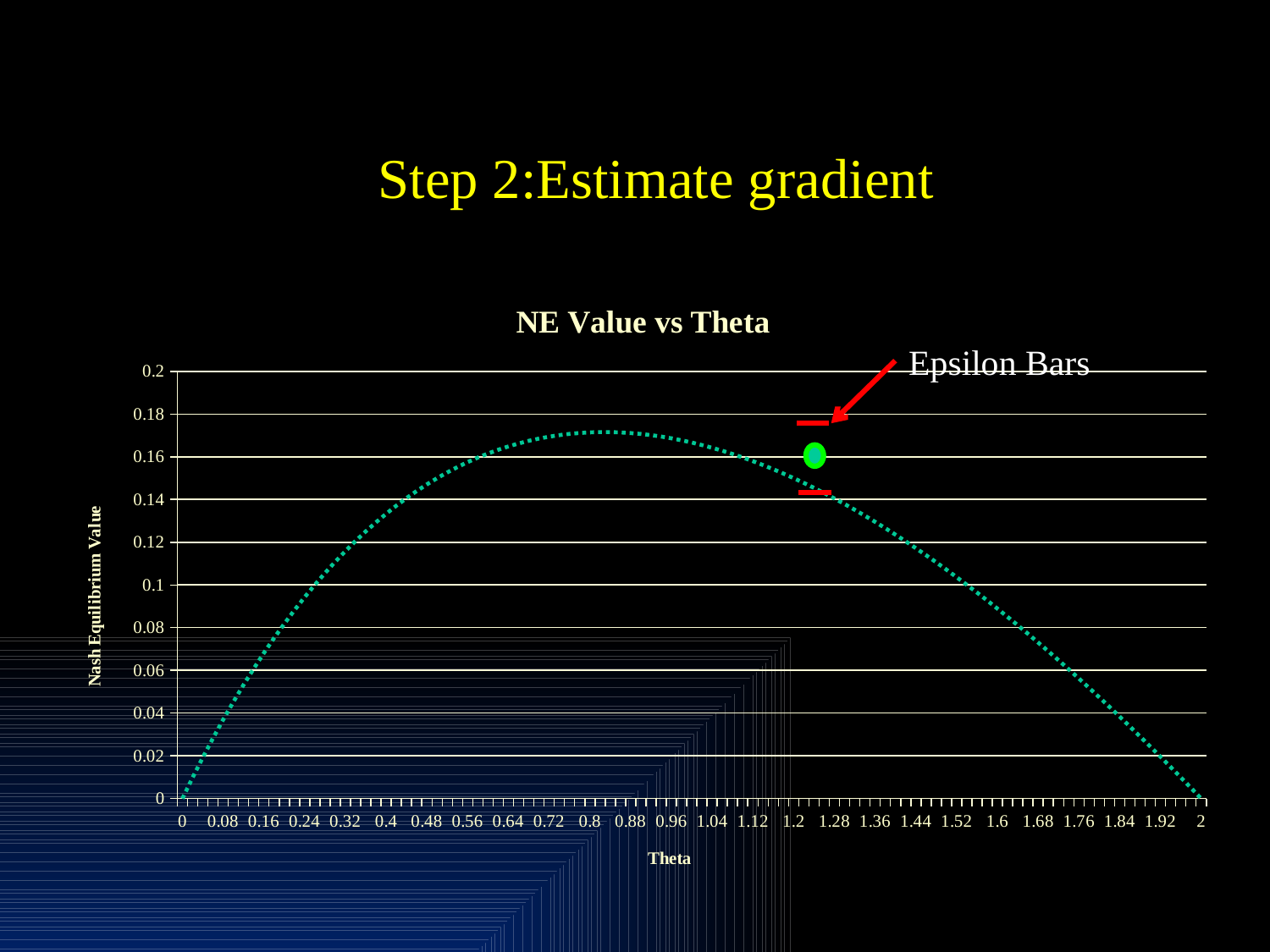
What is the label of the y axis? Nash Equilibrium Value What is the title of the chart? NE Value vs Theta Is the value at Theta = 1.2 greater or less than 0.12? greater How does the Nash Equilibrium Value change as Theta increases from 0 to 2? rises then falls What is the Nash Equilibrium Value at Theta = 2? 0 Is the value at Theta = 1.76 greater or less than 0.08? less What kind of chart is shown on the slide? line chart Is the highest value on the curve greater or less than 0.18? less Which is larger, the value at Theta = 0.48 or the value at Theta = 1.68? Theta = 0.48 What is the Nash Equilibrium Value at Theta = 0? 0